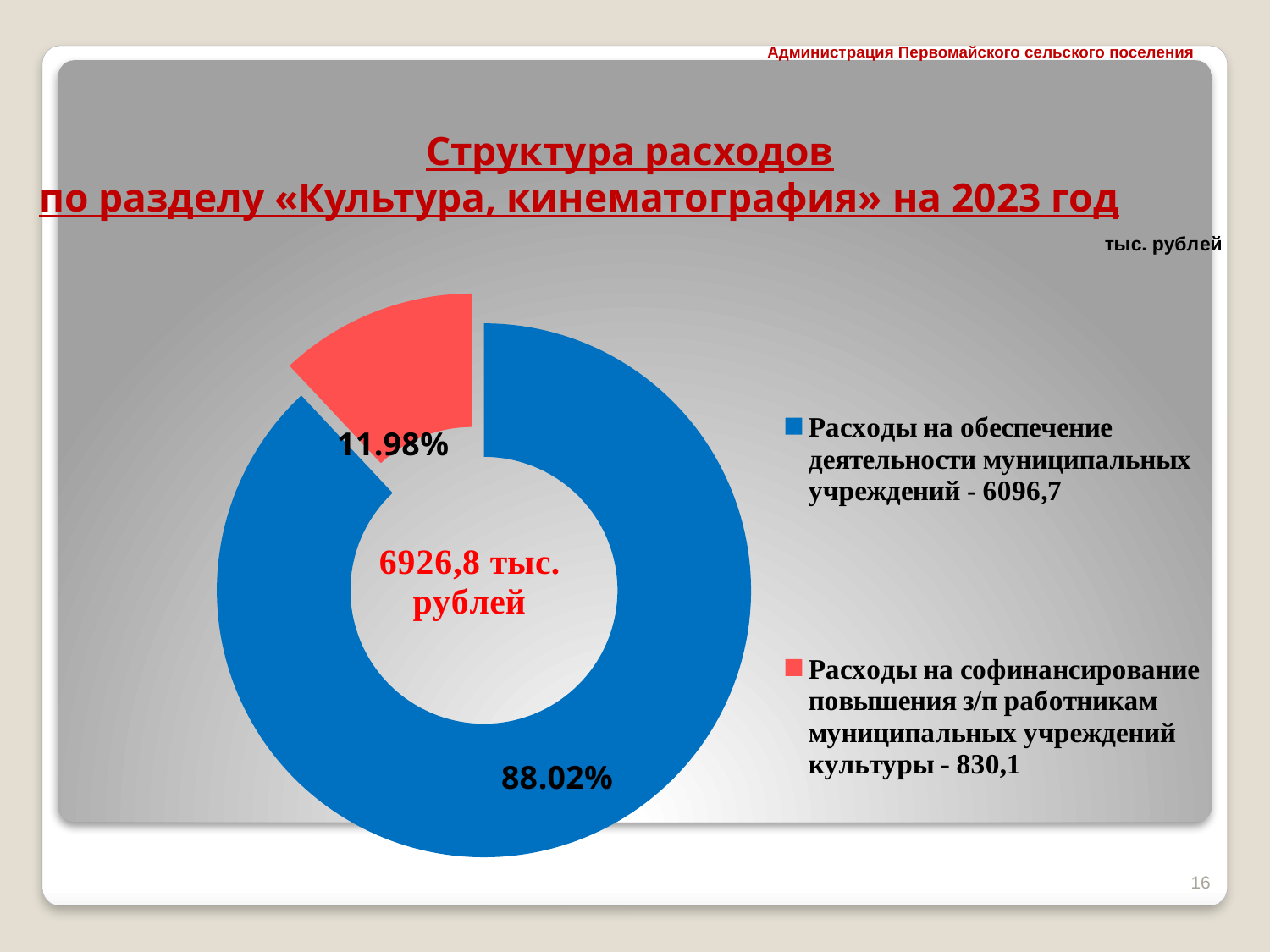
What is the value for «Расходы на обеспечение деятельности муниципальных учреждений» according to the legend? 6096,7 Which category has the largest slice of the chart? Расходы на обеспечение деятельности муниципальных учреждений What total amount is shown in the centre of the chart? 6926,8 тыс. рублей What colour is the slice for «Расходы на софинансирование повышения з/п работникам муниципальных учреждений культуры»? red How many entries does the legend list? 2 How many slices does the chart have? 2 What share of the chart is taken by «Расходы на софинансирование повышения з/п работникам муниципальных учреждений культуры»? 11.98% What kind of chart is shown on the slide? doughnut chart What is the difference between the values for «Расходы на обеспечение деятельности муниципальных учреждений» and «Расходы на софинансирование повышения з/п работникам муниципальных учреждений культуры»? 5266,6 What share of the chart is taken by «Расходы на обеспечение деятельности муниципальных учреждений»? 88.02% What is the value for «Расходы на софинансирование повышения з/п работникам муниципальных учреждений культуры» according to the legend? 830,1 Which category has the smallest slice of the chart? Расходы на софинансирование повышения з/п работникам муниципальных учреждений культуры